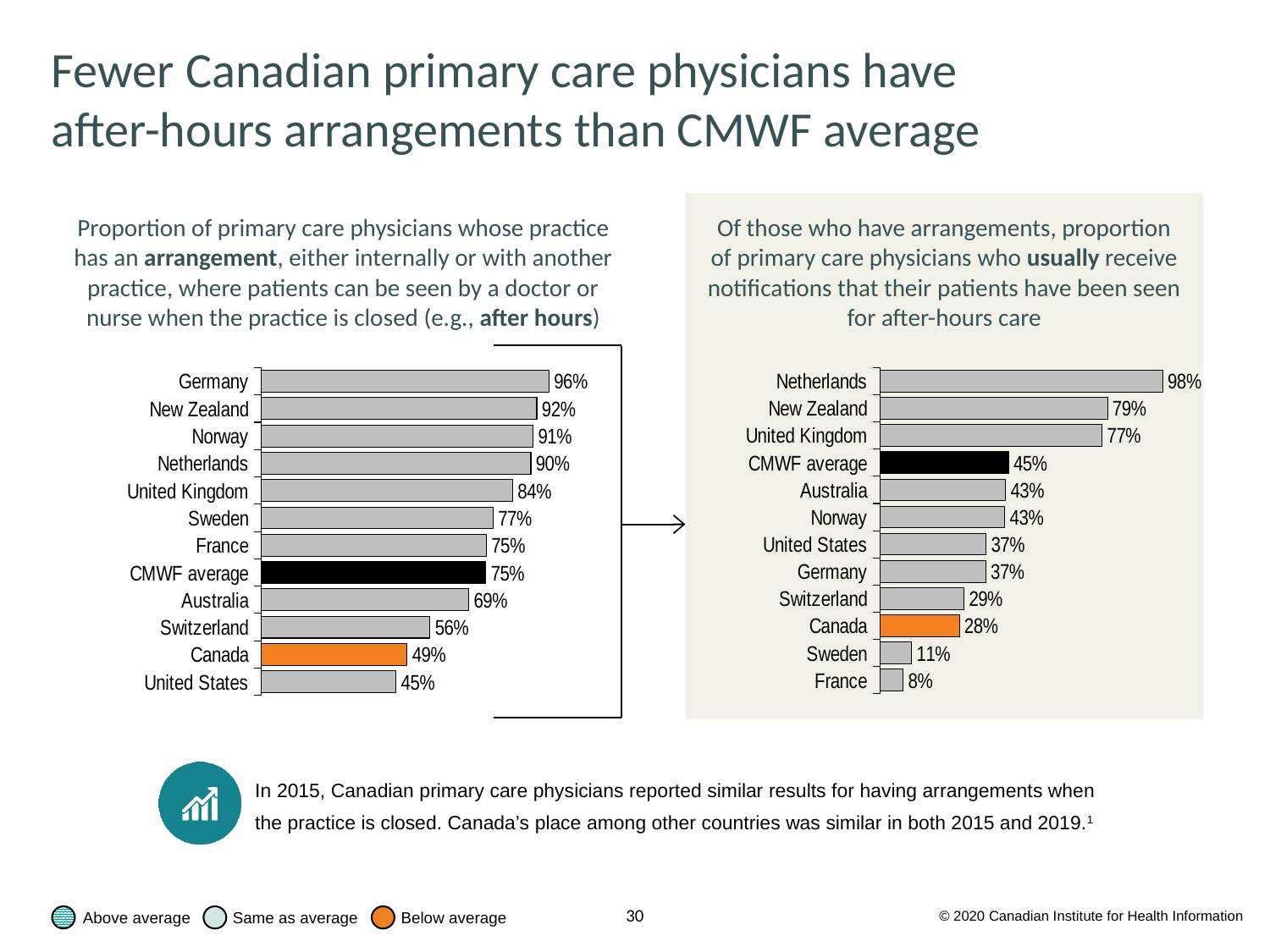
In the right chart (proportion who usually receive notifications of after-hours care), what is the difference between the Netherlands and Canada? 70 percentage points In the left chart (proportion of physicians whose practice has an after-hours arrangement), which country has the lowest value? United States In the left chart (proportion of physicians whose practice has an after-hours arrangement), what colour is the bar for Canada? Orange In the right chart (proportion who usually receive notifications of after-hours care), what is the value for the Netherlands? 98% In the left chart (proportion of physicians whose practice has an after-hours arrangement), what is the difference between the CMWF average and Canada? 26 percentage points In the right chart (proportion who usually receive notifications of after-hours care), which country has the lowest value? France In the right chart (proportion who usually receive notifications of after-hours care), which is larger: the value for New Zealand or the value for the United Kingdom? New Zealand In the left chart (proportion of physicians whose practice has an after-hours arrangement), which country has the highest value? Germany In the left chart (proportion of physicians whose practice has an after-hours arrangement), how many categories are shown? 12 In the right chart (proportion who usually receive notifications of after-hours care), what is the value for the CMWF average? 45% What type of chart is used on the left side of the slide? Bar chart In the left chart (proportion of physicians whose practice has an after-hours arrangement), what is the value for Canada? 49%